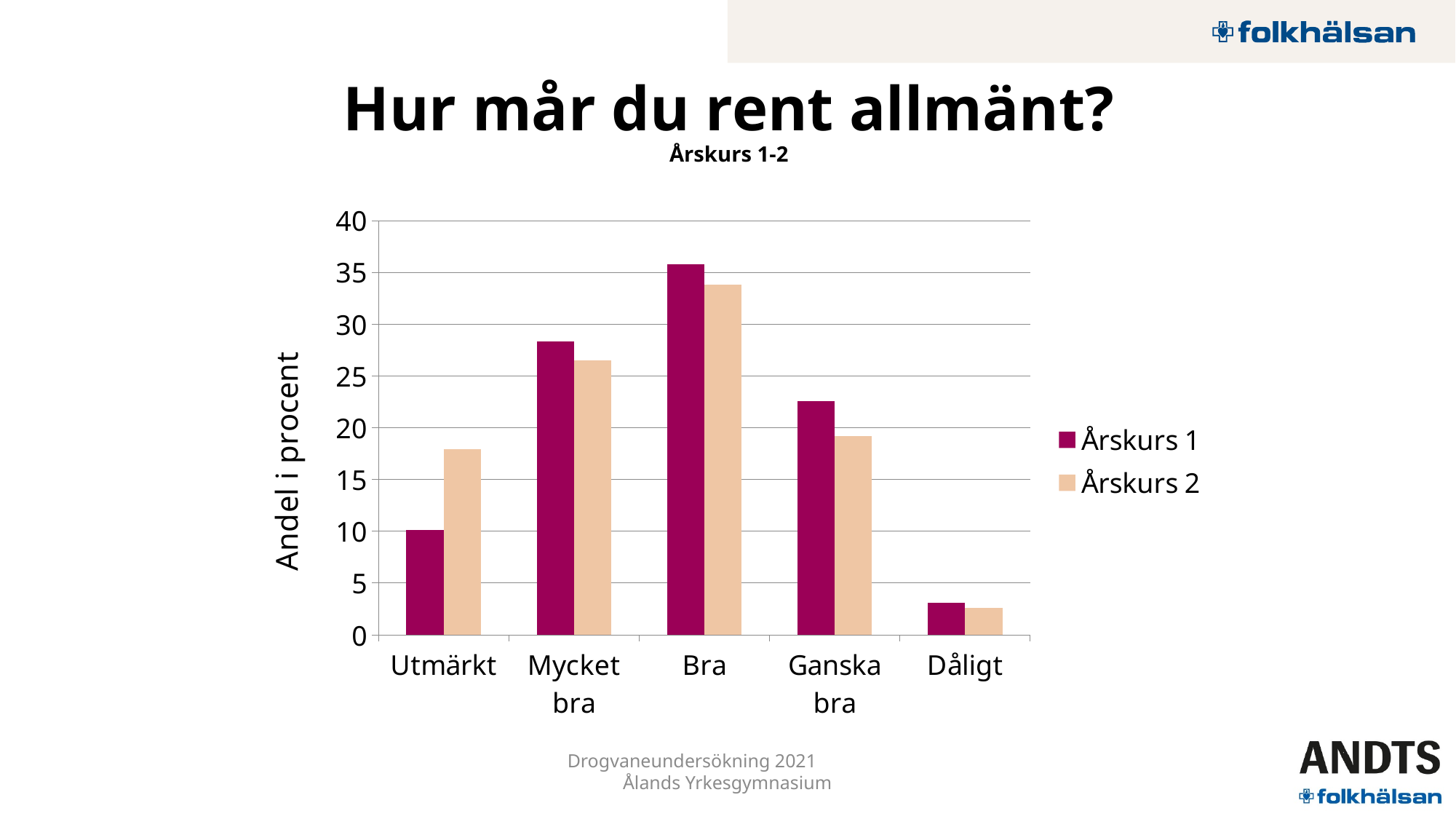
What kind of chart is shown on the slide? bar chart Which category has the highest value for Årskurs 1? Bra Which category has the lowest value for Årskurs 1? Dåligt What is the label on the vertical axis of the chart? Andel i procent For Utmärkt, which series has the larger value, Årskurs 1 or Årskurs 2? Årskurs 2 Which category has the highest value for Årskurs 2? Bra Is the value for Bra in Årskurs 2 greater or less than 35? less For Ganska bra, which series has the larger value, Årskurs 1 or Årskurs 2? Årskurs 1 How many series does the legend list? 2 Is the value for Utmärkt in Årskurs 2 greater or less than 15? greater How many response categories are shown on the x axis? 5 Is the value for Dåligt in Årskurs 1 greater or less than 5? less